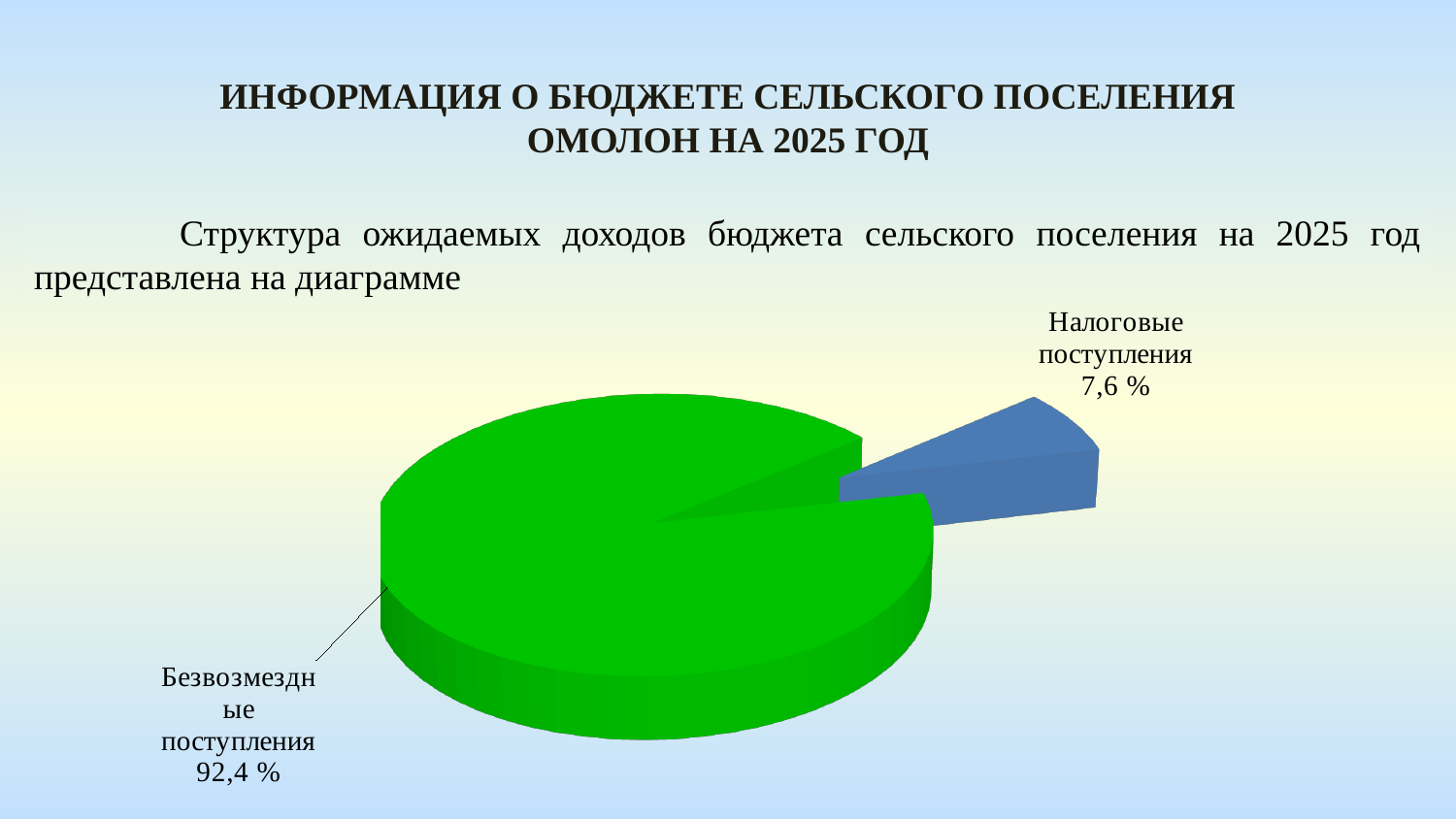
Which is larger: Безвозмездные поступления or Налоговые поступления? Безвозмездные поступления By how many percentage points does Безвозмездные поступления exceed Налоговые поступления? 84,8 % Which slice of the pie is the largest? Безвозмездные поступления What share of the pie is labelled for Налоговые поступления? 7,6 % What colour is the slice for Безвозмездные поступления? green Is the share for Налоговые поступления greater or less than 10 %? less Is the share for Безвозмездные поступления greater or less than 90 %? greater What share of the pie is labelled for Безвозмездные поступления? 92,4 % Which slice of the pie is the smallest? Налоговые поступления How many slices does the pie chart have? 2 What kind of chart is shown on the slide? pie chart What colour is the slice for Налоговые поступления? blue